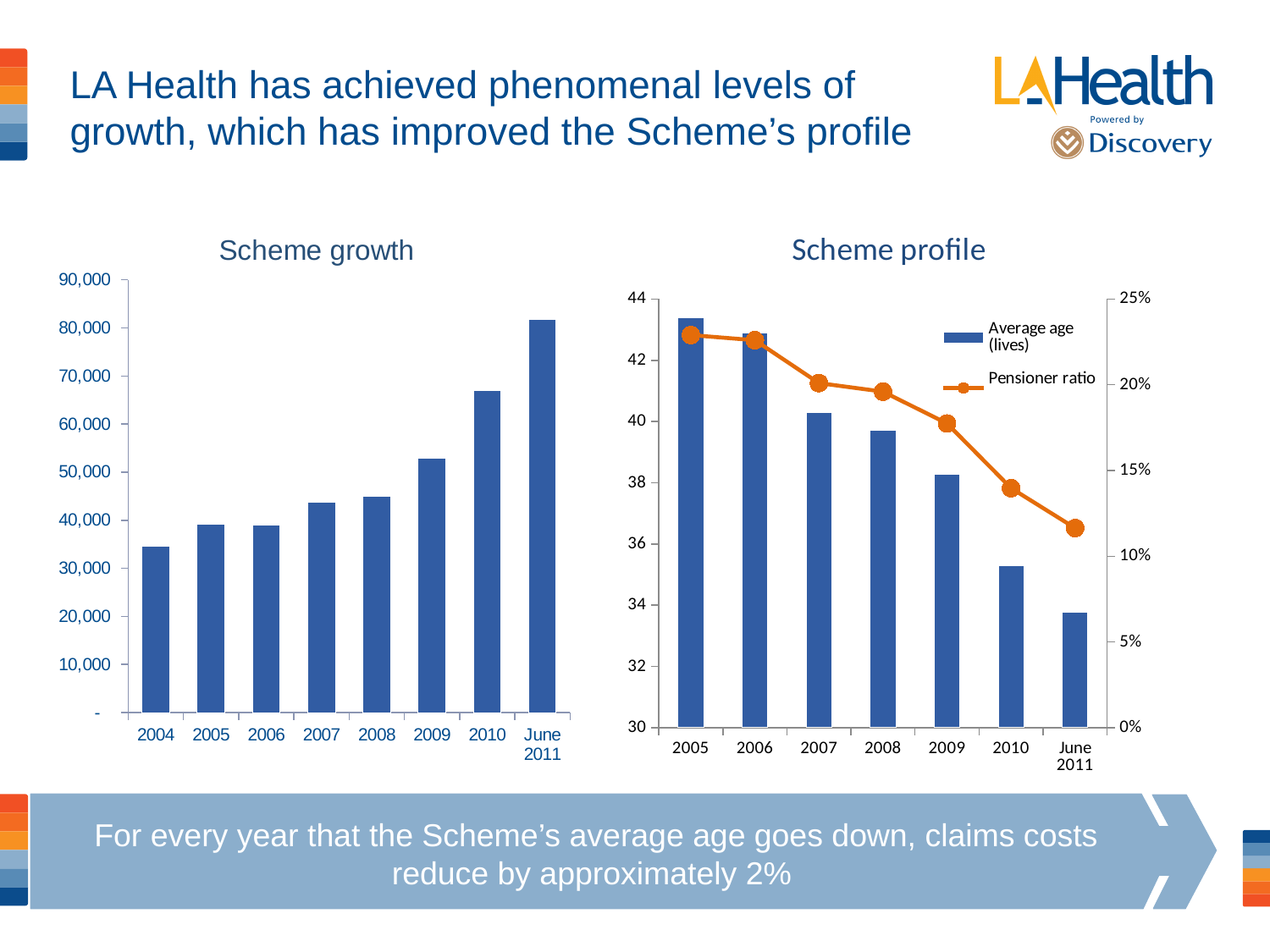
On the Scheme growth chart, which year has the lowest value? 2004 On the Scheme growth chart, is the value for 2010 greater or less than 60,000? greater On the Scheme profile chart, how many series does the legend list? 2 What kind of chart is the Scheme growth chart? Bar chart On the Scheme growth chart, which year has the highest value? June 2011 On the Scheme growth chart, how many bars are plotted? 8 On the Scheme profile chart, is the Pensioner ratio for June 2011 greater or less than 10%? greater On the Scheme growth chart, which is larger, the value for 2009 or the value for 2007? 2009 On the Scheme growth chart, is the value for 2004 greater or less than 40,000? less On the Scheme profile chart, does the Pensioner ratio rise or fall from 2005 to June 2011? Fall On the Scheme profile chart, which year has the highest Average age (lives)? 2005